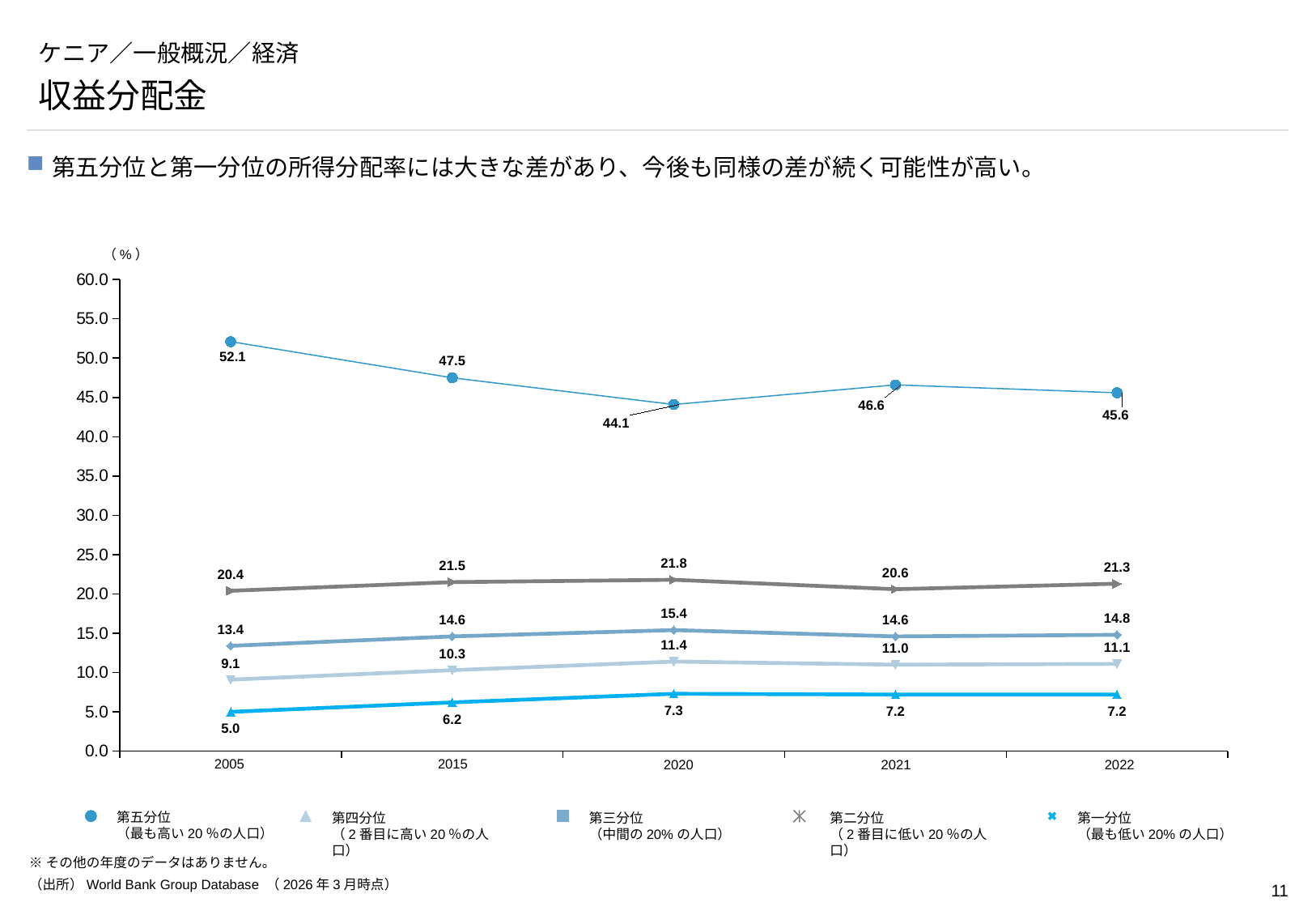
What is the value for 第五分位 in 2020? 44.1 What type of chart is shown on the slide? line chart How many years are plotted on the x axis? 5 What is the value for 第一分位 in 2005? 5.0 What is the value for 第一分位 in 2022? 7.2 How many series does the legend list? 5 What is the value for 第五分位 in 2005? 52.1 Which is larger, the 第五分位 value in 2021 or in 2022? 2021 In which year is the value for 第五分位 highest? 2005 What is the difference between the 第五分位 value in 2005 and in 2022? 6.5 What unit is shown on the y axis? % In which year is the value for 第五分位 lowest? 2020